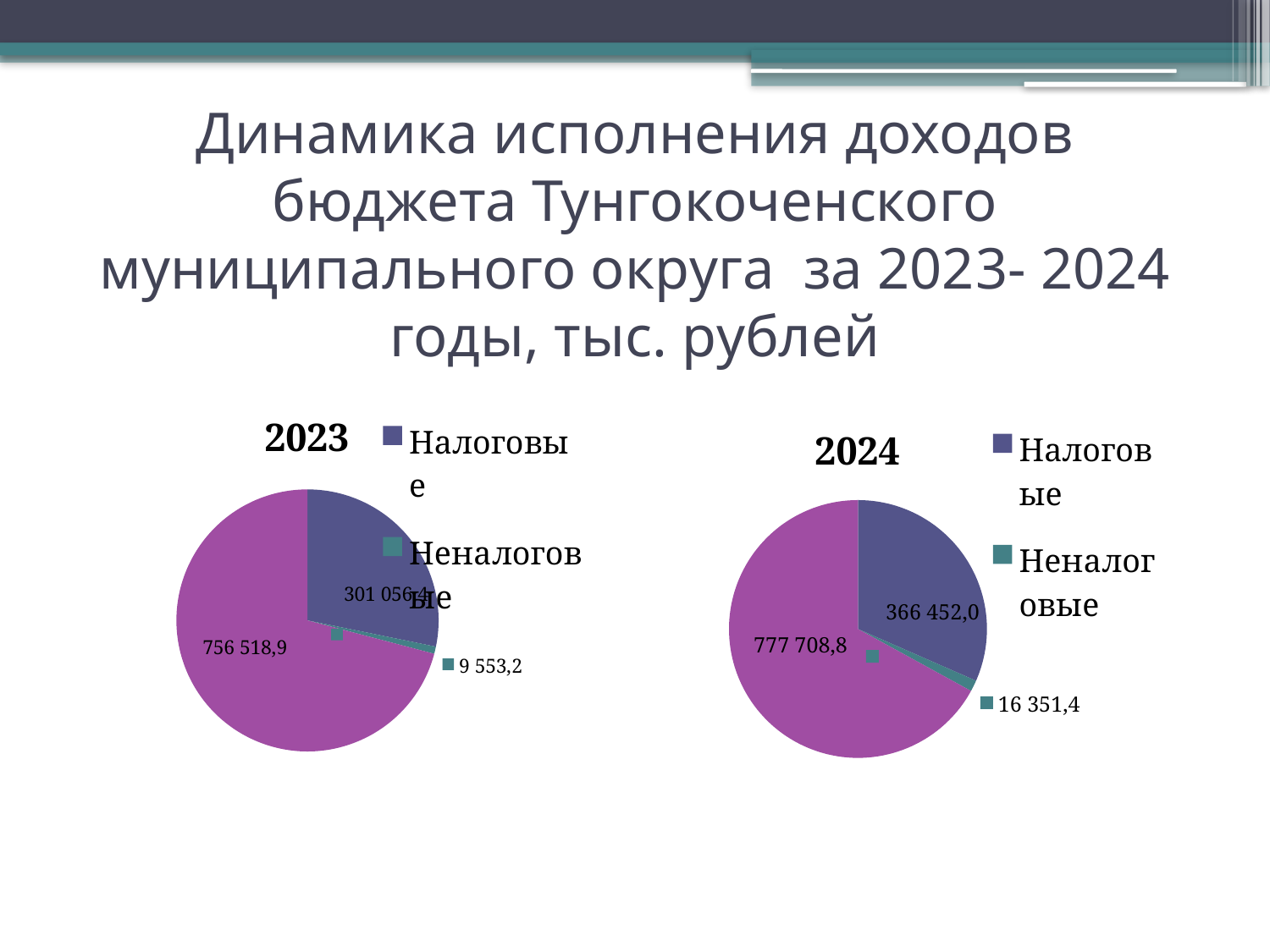
In the 2023 chart, what is the value printed on the largest slice? 756 518,9 How many slices does the 2024 pie chart have? 3 By how much does the Неналоговые value in the 2024 chart exceed the Неналоговые value in the 2023 chart? 6 798,2 In the 2023 chart, what is the value for Неналоговые? 9 553,2 In the 2024 chart, what is the value printed on the largest slice? 777 708,8 In the 2024 chart, what is the value for Неналоговые? 16 351,4 In the 2024 chart, which is larger, Налоговые or Неналоговые? Налоговые How many entries does the legend of the 2023 chart list? 2 In the 2024 chart, which labelled category has the smallest slice? Неналоговые In the 2024 chart, what is the value for Налоговые? 366 452,0 Comparing the 2023 and 2024 charts, which year has the larger value for Неналоговые? 2024 What kind of chart is the 2024 chart? pie chart